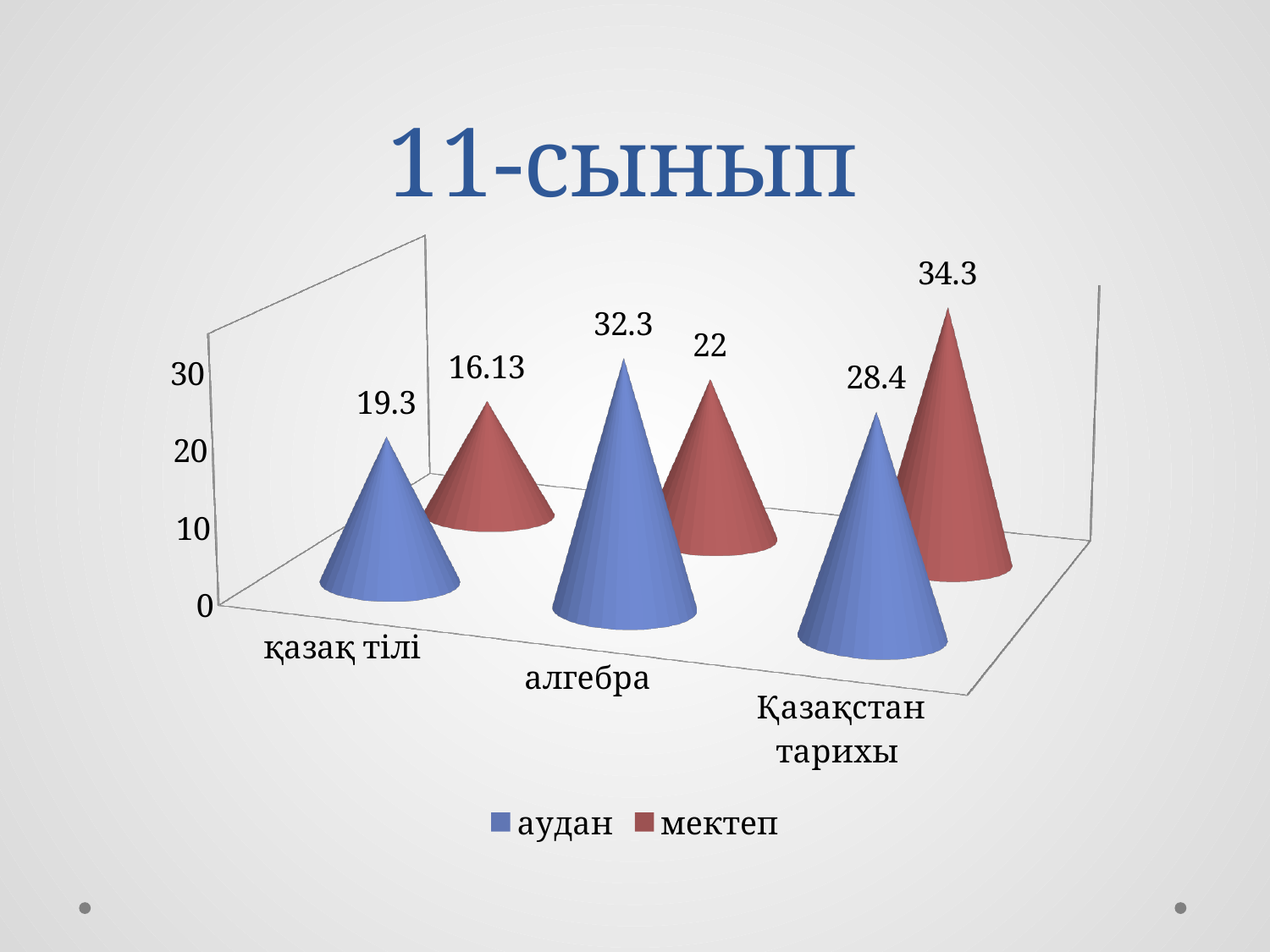
How many series does the legend list? 2 What kind of chart is shown on the slide? bar chart Which category has the highest value for the аудан series? алгебра What is the value for аудан in the Қазақстан тарихы category? 28.4 Which category has the lowest value for the мектеп series? қазақ тілі What is the value for аудан in the алгебра category? 32.3 What is the difference between the аудан and мектеп values for алгебра? 10.3 For Қазақстан тарихы, which series has the larger value, аудан or мектеп? мектеп What is the value for мектеп in the Қазақстан тарихы category? 34.3 What is the title of the chart? 11-сынып How many categories are shown on the x axis? 3 What is the value for мектеп in the қазақ тілі category? 16.13